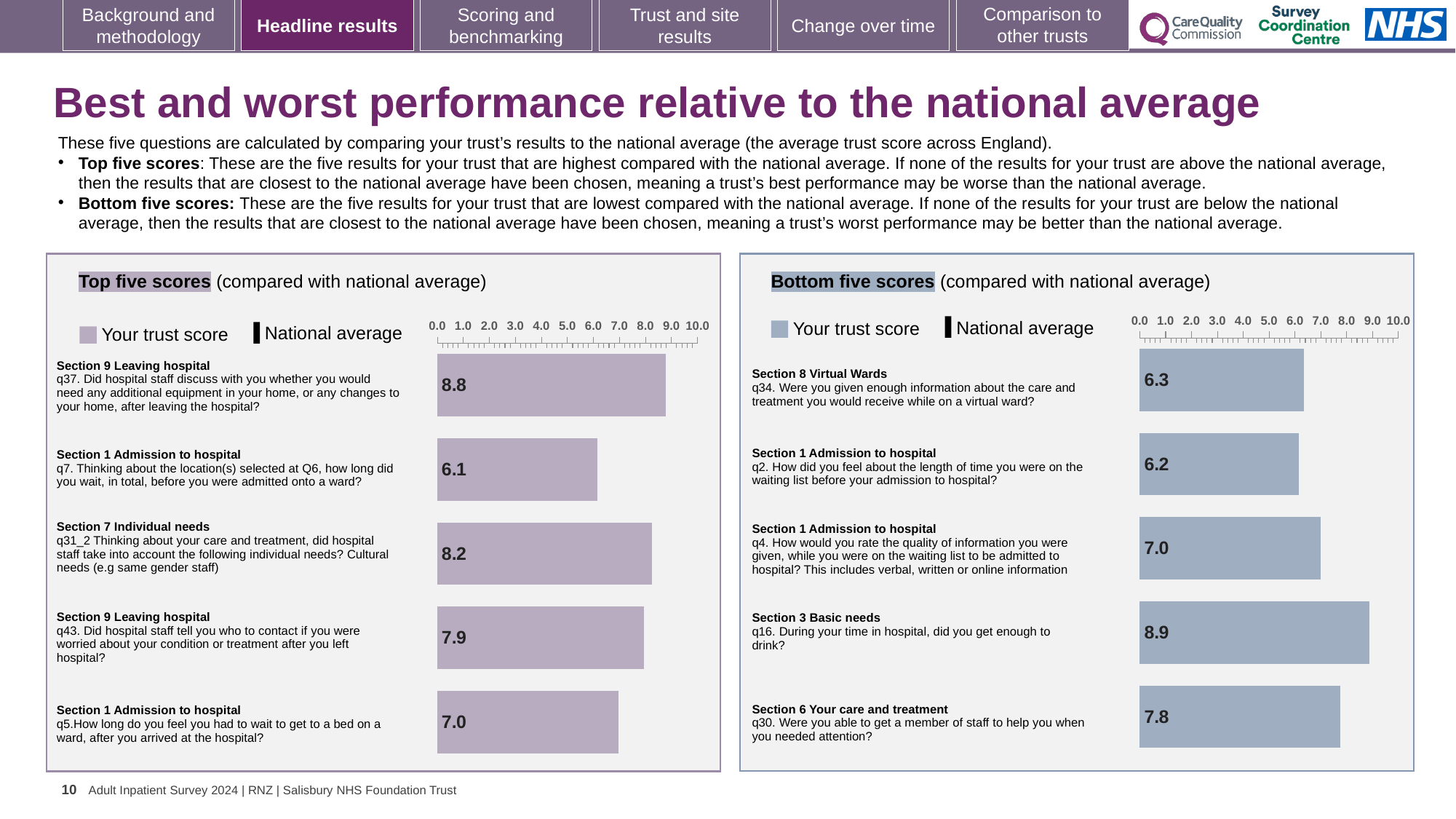
In the Top five scores chart, what is the trust score for q37 (Did hospital staff discuss with you whether you would need any additional equipment in your home)? 8.8 In the Top five scores chart, which has the larger trust score: q31_2 or q43? q31_2 In the Top five scores chart, which question has the highest trust score? q37 (Section 9 Leaving hospital) In the Top five scores chart, what is the trust score for q5 (How long do you feel you had to wait to get to a bed on a ward)? 7.0 In the Bottom five scores chart, which question has the lowest trust score? q2 (Section 1 Admission to hospital) How many bars are shown in the Bottom five scores chart? 5 In the Top five scores chart, what is the difference between the trust scores for q37 and q7? 2.7 What type of chart is used in the Top five scores panel? Bar chart In the Bottom five scores chart, is the trust score for q34 greater or less than 5.0? greater In the Bottom five scores chart, what is the trust score for q16 (During your time in hospital, did you get enough to drink)? 8.9 In the Top five scores chart, which question has the lowest trust score? q7 (Section 1 Admission to hospital) In the Bottom five scores chart, what is the difference between the trust scores for q30 and q34? 1.5